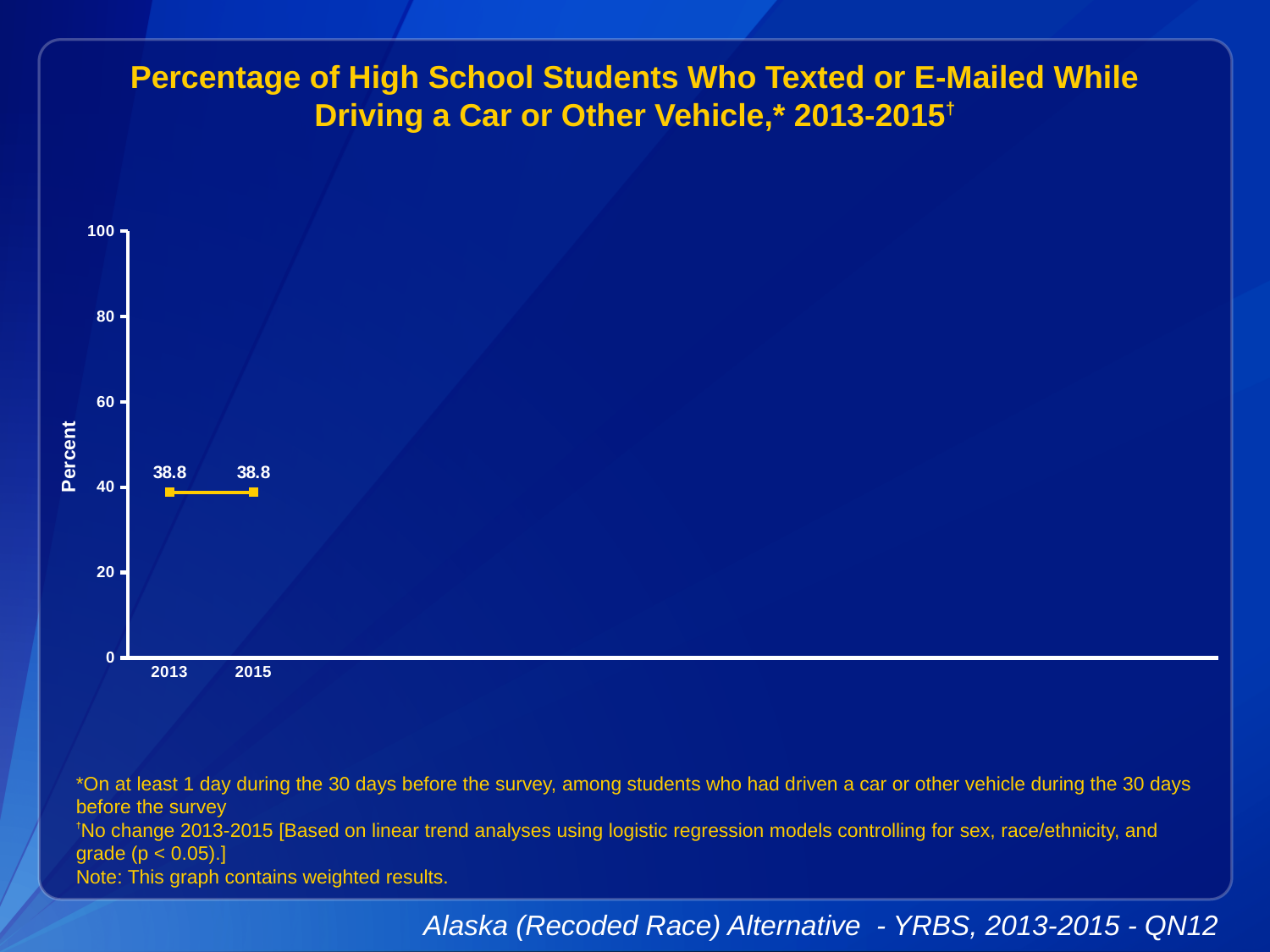
Is the value for 2015 greater or less than 20? greater What is the maximum value shown on the y axis? 100 What is the label on the y axis? Percent What is the value for 2015? 38.8 Do the values rise, fall, or stay the same from 2013 to 2015? stay the same What is the difference between the 2013 and 2015 values? 0 How many data points are plotted on the chart? 2 What is the value for 2013? 38.8 What kind of chart is shown on the slide? line chart Is the value for 2013 greater or less than 40? less